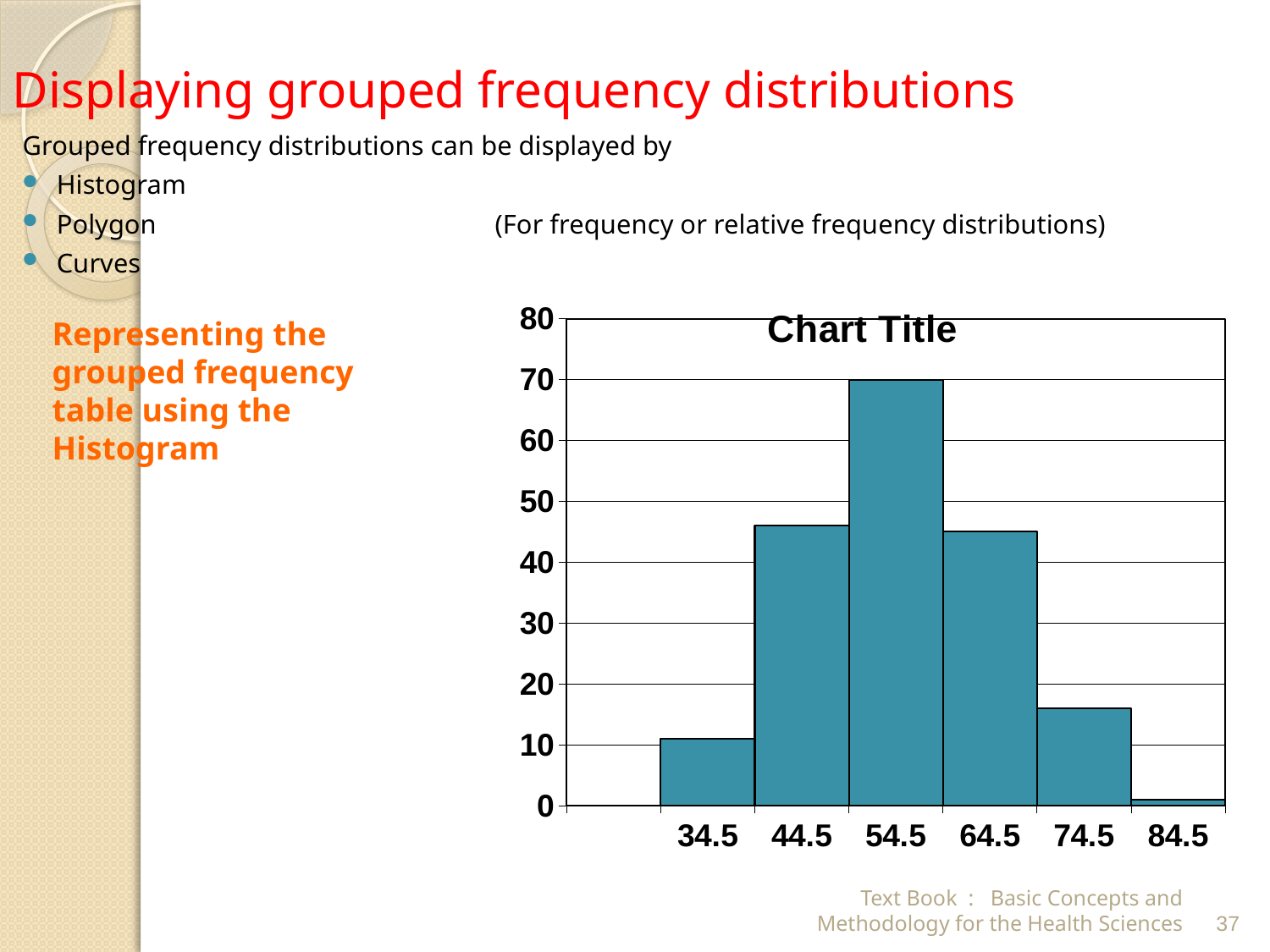
Is the value for 64.5 greater or less than 50? less Do the bar values rise or fall from 54.5 to 84.5 along the x axis? fall How many bars are plotted in the chart? 6 Is the value for 34.5 greater or less than 20? less What type of chart is shown on the slide? bar chart Is the value for 44.5 greater or less than 40? greater What is the value of the bar at 54.5? 70 Which category has the highest bar? 54.5 Which category has the lowest bar? 84.5 Which is larger, the bar at 34.5 or the bar at 74.5? 74.5 What is the title of the chart? Chart Title